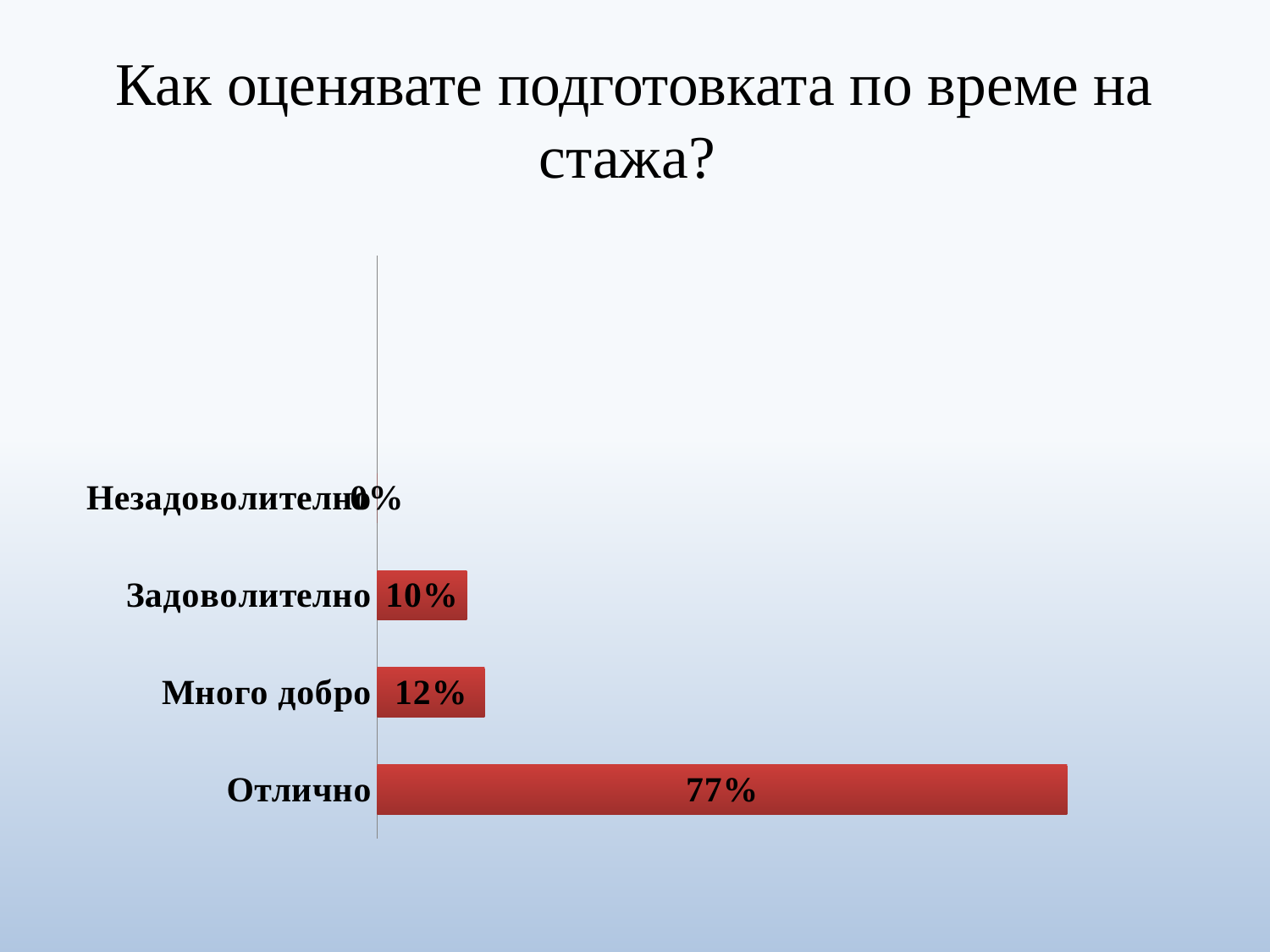
What is the difference between the values for Отлично and Много добро? 65% What is the value for Много добро? 12% What is the title of the slide? Как оценявате подготовката по време на стажа? What is the difference between the values for Много добро and Задоволително? 2% How many categories are shown in the chart? 4 Which is larger, the value for Отлично or the value for Задоволително? Отлично What is the value for Задоволително? 10% What is the value for Отлично? 77% What kind of chart is shown on the slide? Bar chart What is the value for Незадоволително? 0% Which category has the highest value? Отлично Which category has the lowest value? Незадоволително